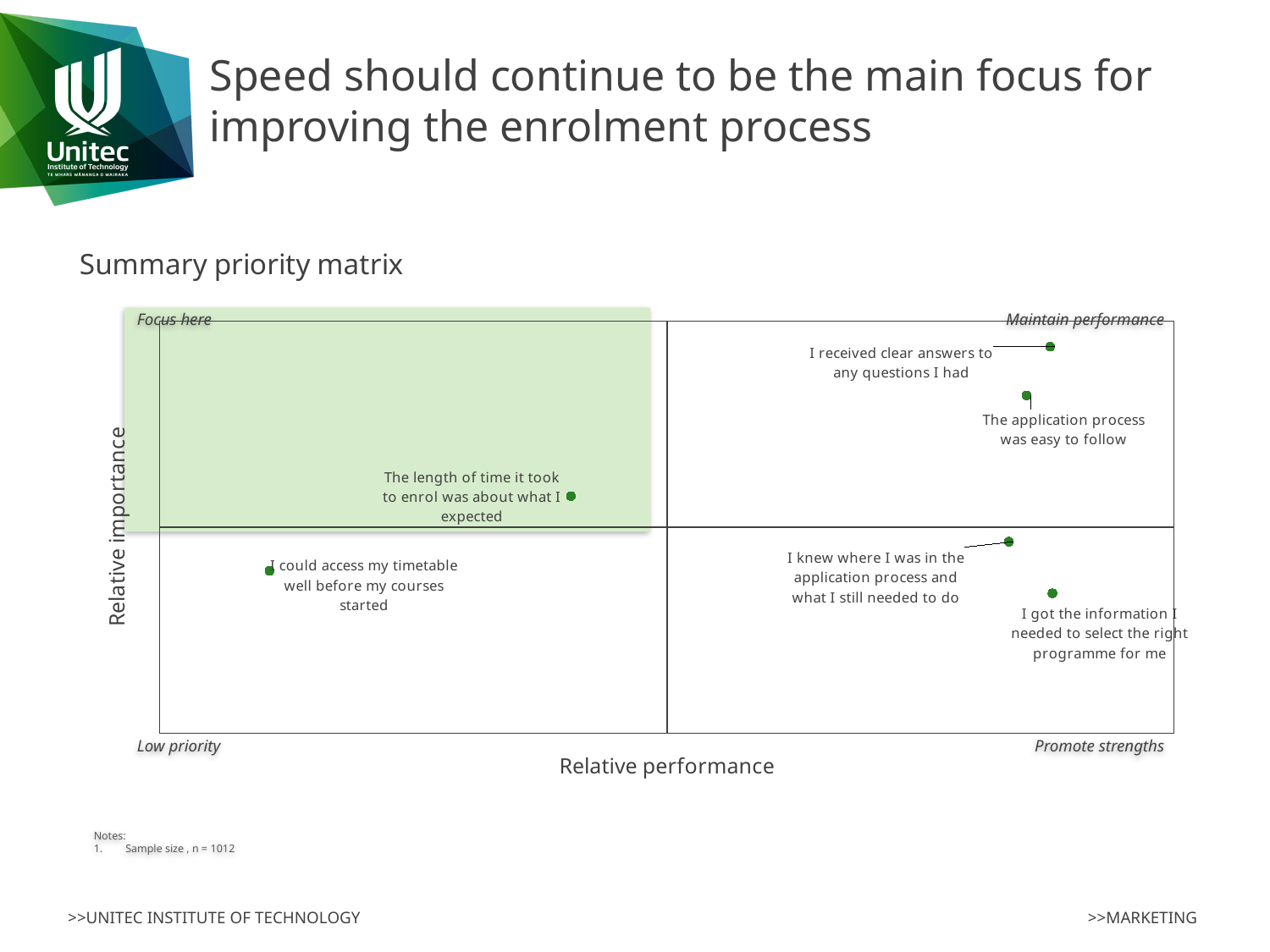
Which quadrant is 'I could access my timetable well before my courses started' plotted in? Low priority How many statements are plotted in the 'Maintain performance' quadrant? 2 Which statement is plotted in the 'Focus here' quadrant? The length of time it took to enrol was about what I expected Which has higher relative performance: 'The length of time it took to enrol was about what I expected' or 'I knew where I was in the application process and what I still needed to do'? I knew where I was in the application process and what I still needed to do Which has higher relative importance: 'I received clear answers to any questions I had' or 'I could access my timetable well before my courses started'? I received clear answers to any questions I had Which quadrant is 'I got the information I needed to select the right programme for me' plotted in? Promote strengths What is the title of the horizontal axis of the priority matrix? Relative performance Which statement has the lowest relative performance? I could access my timetable well before my courses started What is the title of the vertical axis of the priority matrix? Relative importance What kind of chart is shown on the slide? Scatter chart Which statement has the highest relative importance? I received clear answers to any questions I had